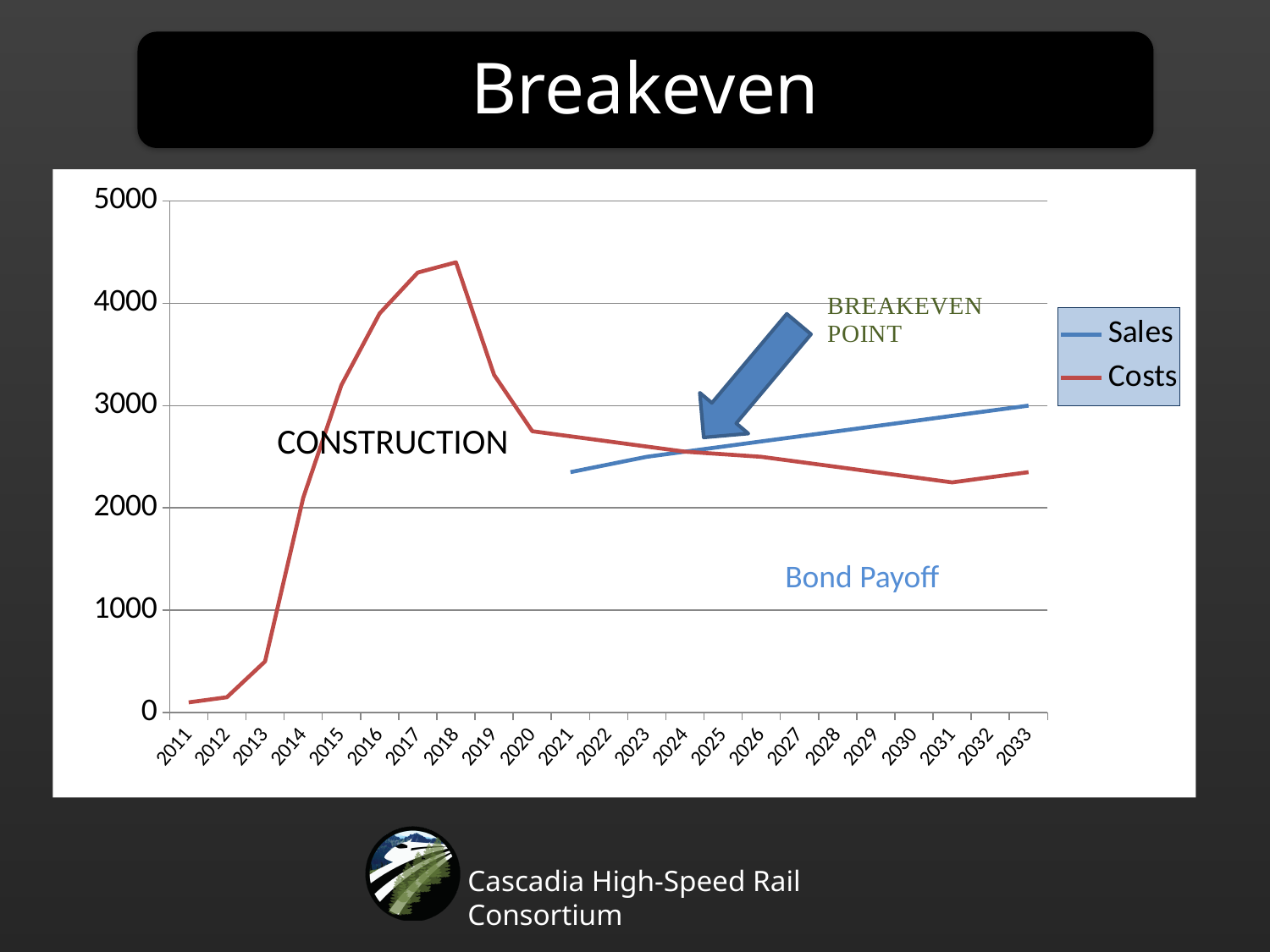
How many series does the legend list? 2 In which year does the Costs line reach its highest value? 2018 In which year is the Costs value lowest? 2011 Which two series are named in the legend? Sales and Costs How many years are shown along the x axis? 23 Does the Sales line rise or fall from 2021 to 2033? rise Is the Sales value for 2021 greater or less than 2000? greater Is the Costs value for 2018 greater or less than 4000? greater What kind of chart is shown on the slide? line chart Is the Sales value for 2033 greater or less than 4000? less In 2033, which is larger, Sales or Costs? Sales